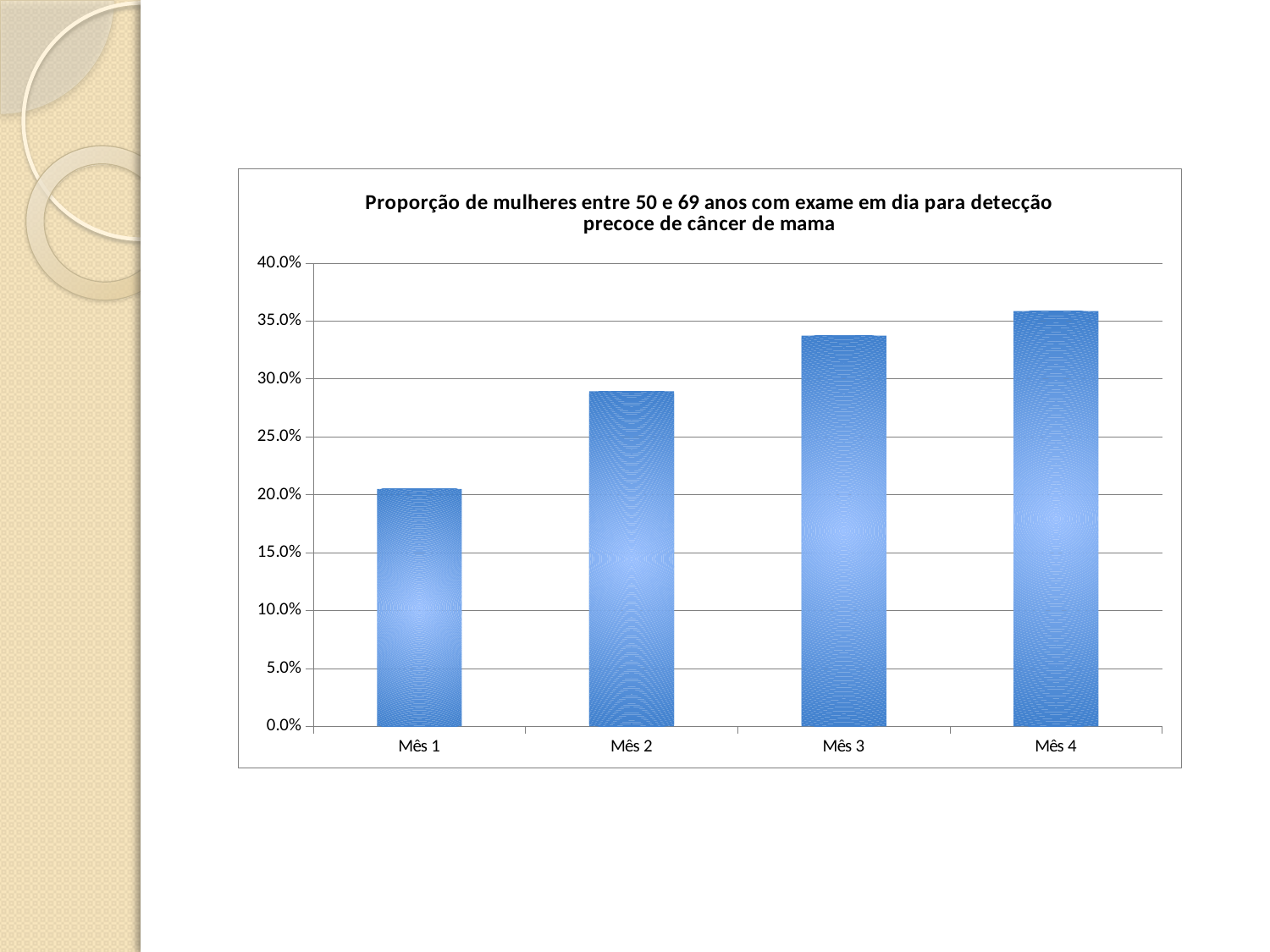
Which month has the lowest proportion? Mês 1 What is the maximum value shown on the vertical axis? 40.0% Is the value for Mês 1 greater or less than 25.0%? less Is the value for Mês 2 greater or less than 25.0%? greater Which month has the highest proportion? Mês 4 Which is larger, the value for Mês 2 or the value for Mês 3? Mês 3 What is the title of the chart? Proporção de mulheres entre 50 e 69 anos com exame em dia para detecção precoce de câncer de mama Is the value for Mês 3 greater or less than 30.0%? greater What kind of chart is shown on the slide? bar chart Do the values rise or fall from Mês 1 to Mês 4? rise How many categories (months) are plotted on the chart? 4